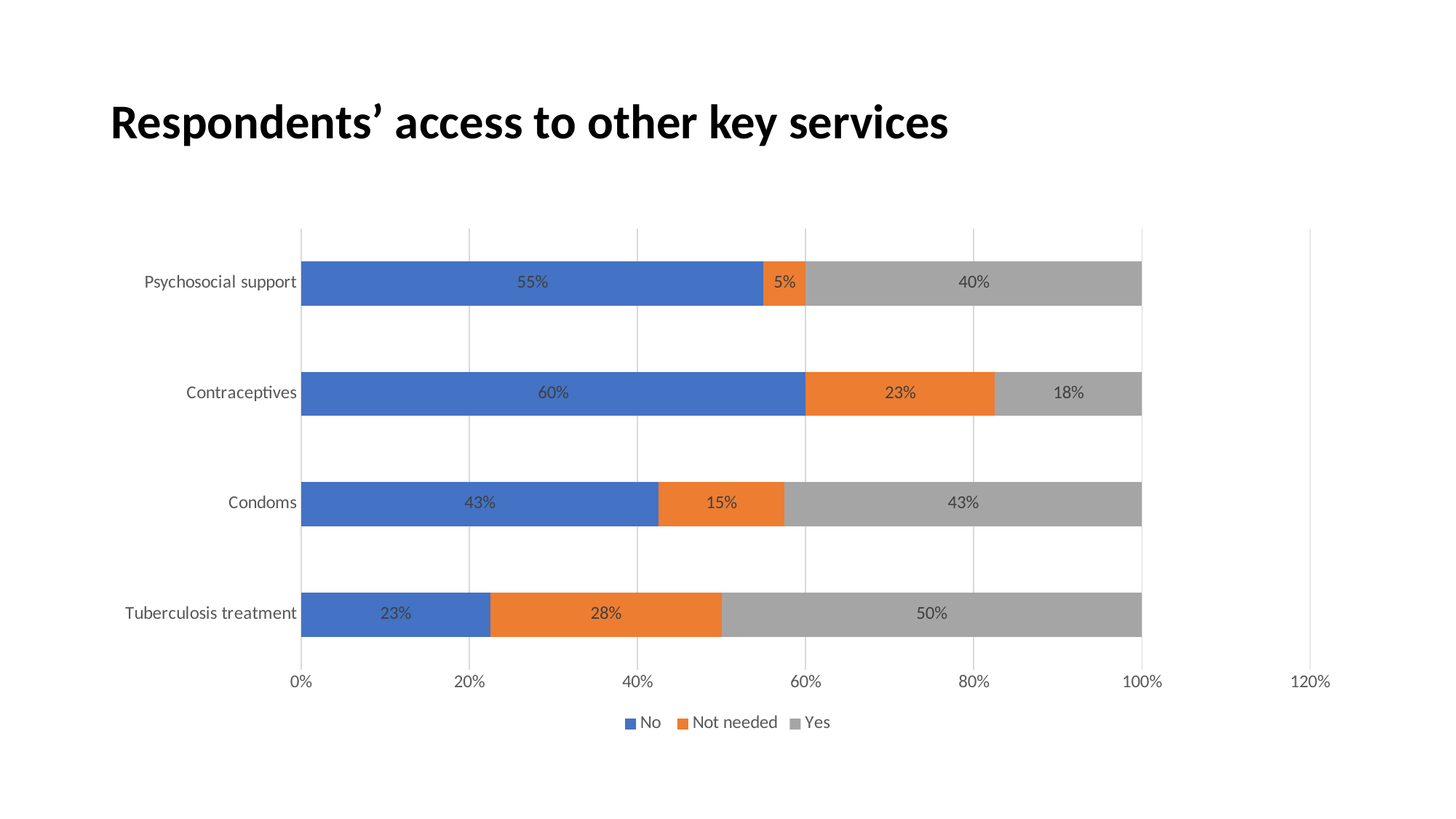
What is the difference between the "Yes" percentage for Tuberculosis treatment and the "Yes" percentage for Psychosocial support? 10% What percentage of respondents answered "No" for Psychosocial support? 55% What percentage of respondents answered "Yes" for Tuberculosis treatment? 50% What percentage of respondents answered "Not needed" for Contraceptives? 23% Which service has the lowest "Yes" percentage? Contraceptives What is the total of the stacked bar for Condoms? 101% How many series does the legend list? 3 What kind of chart is shown on the slide? Stacked bar chart Which service has the highest "No" percentage? Contraceptives Which is larger: the "Not needed" percentage for Tuberculosis treatment or for Condoms? Tuberculosis treatment What is the title of the chart? Respondents' access to other key services How many services are shown on the chart? 4